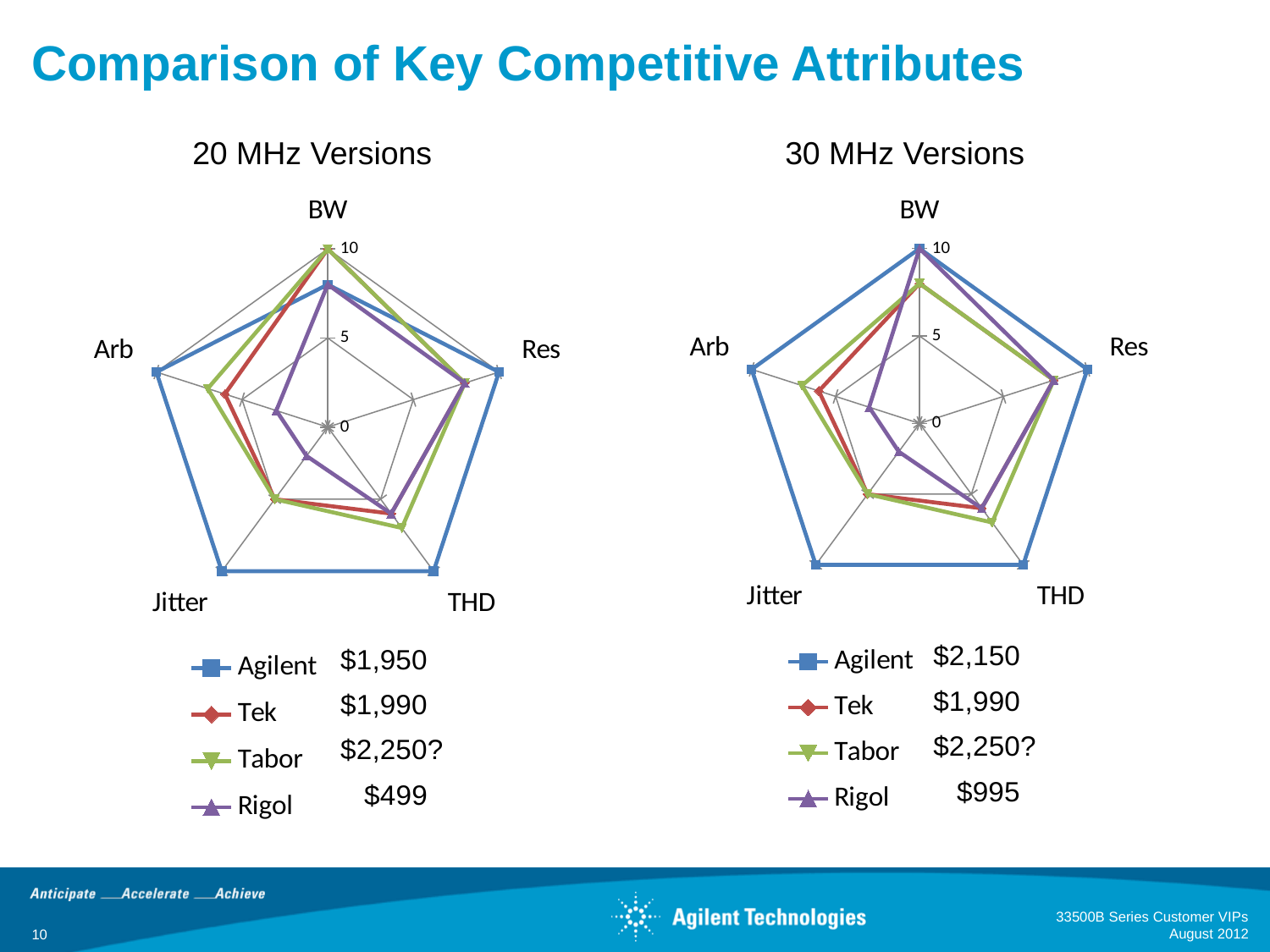
In the "20 MHz Versions" chart, which is larger, the Jitter value for Agilent or the Jitter value for Rigol? Agilent In the "30 MHz Versions" chart, is the BW value for Tek greater or less than 5? greater How many series does the legend of the "30 MHz Versions" chart list? 4 How many attribute axes does the "20 MHz Versions" radar chart have? 5 What kind of chart is the "20 MHz Versions" chart? Radar chart In the "30 MHz Versions" chart, which series has the highest BW value? Agilent and Rigol (tied at 10) In the "20 MHz Versions" chart, what is the Arb value for Agilent? 10 In the "30 MHz Versions" chart, what is the BW value for Agilent? 10 In the "20 MHz Versions" chart, which series has the lowest Arb value? Rigol What is the title of the slide containing the two radar charts? Comparison of Key Competitive Attributes In the "20 MHz Versions" chart, is the Arb value for Rigol greater or less than 5? less In the "30 MHz Versions" chart, which series has the lowest Jitter value? Rigol